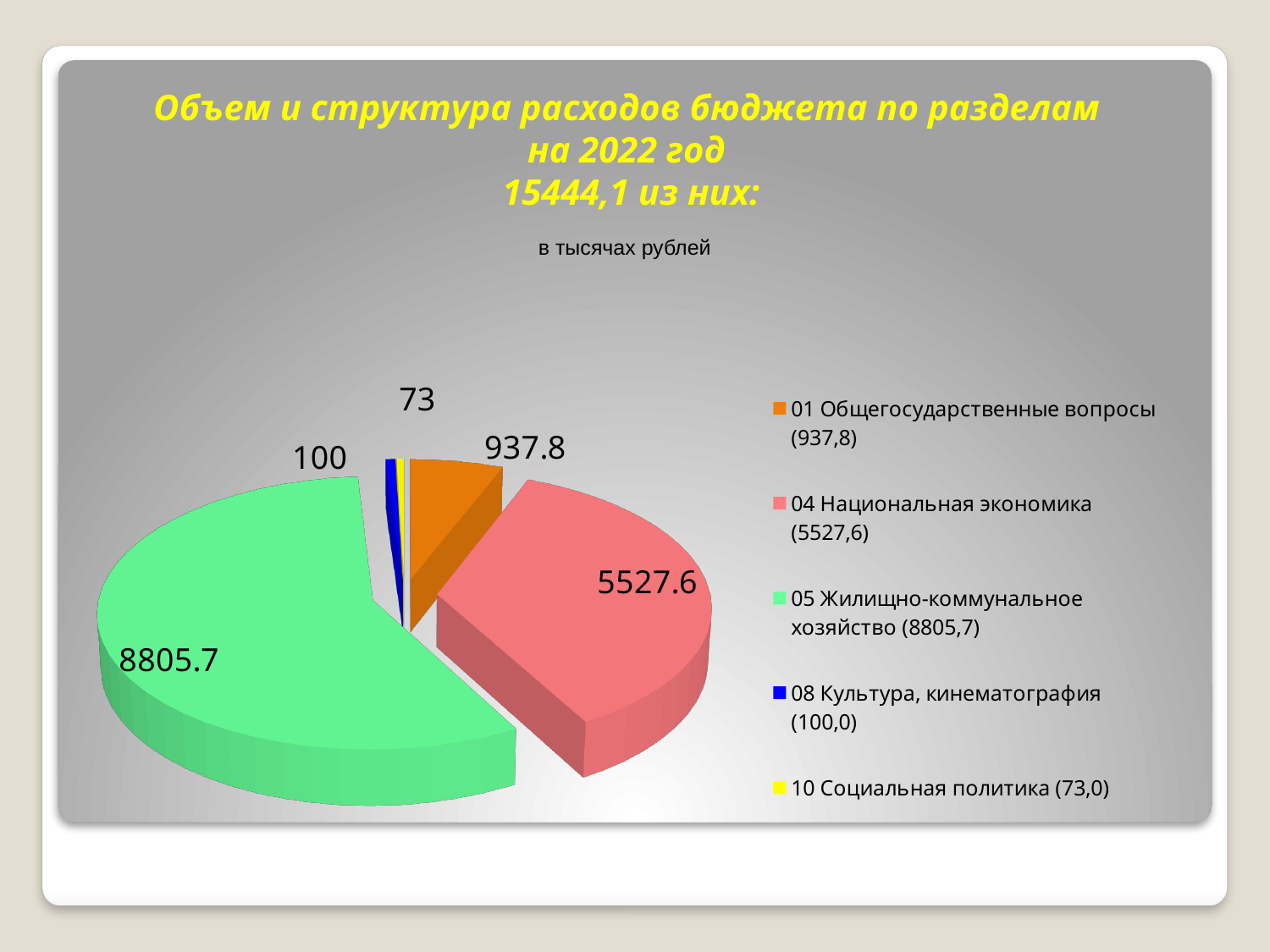
Which is larger: the value for 01 Общегосударственные вопросы or 08 Культура, кинематография? 01 Общегосударственные вопросы How many entries does the legend list? 5 What is the value for 05 Жилищно-коммунальное хозяйство? 8805.7 Which section has the smallest share of the pie? 10 Социальная политика How many slices does the pie chart have? 5 What type of chart is shown on the slide? pie chart What is the value for 10 Социальная политика? 73 What colour is the slice for 04 Национальная экономика? pink What is the difference between the values for 05 Жилищно-коммунальное хозяйство and 04 Национальная экономика? 3278.1 Which section has the largest share of the pie? 05 Жилищно-коммунальное хозяйство What is the value for 04 Национальная экономика? 5527.6 What is the value for 01 Общегосударственные вопросы? 937.8